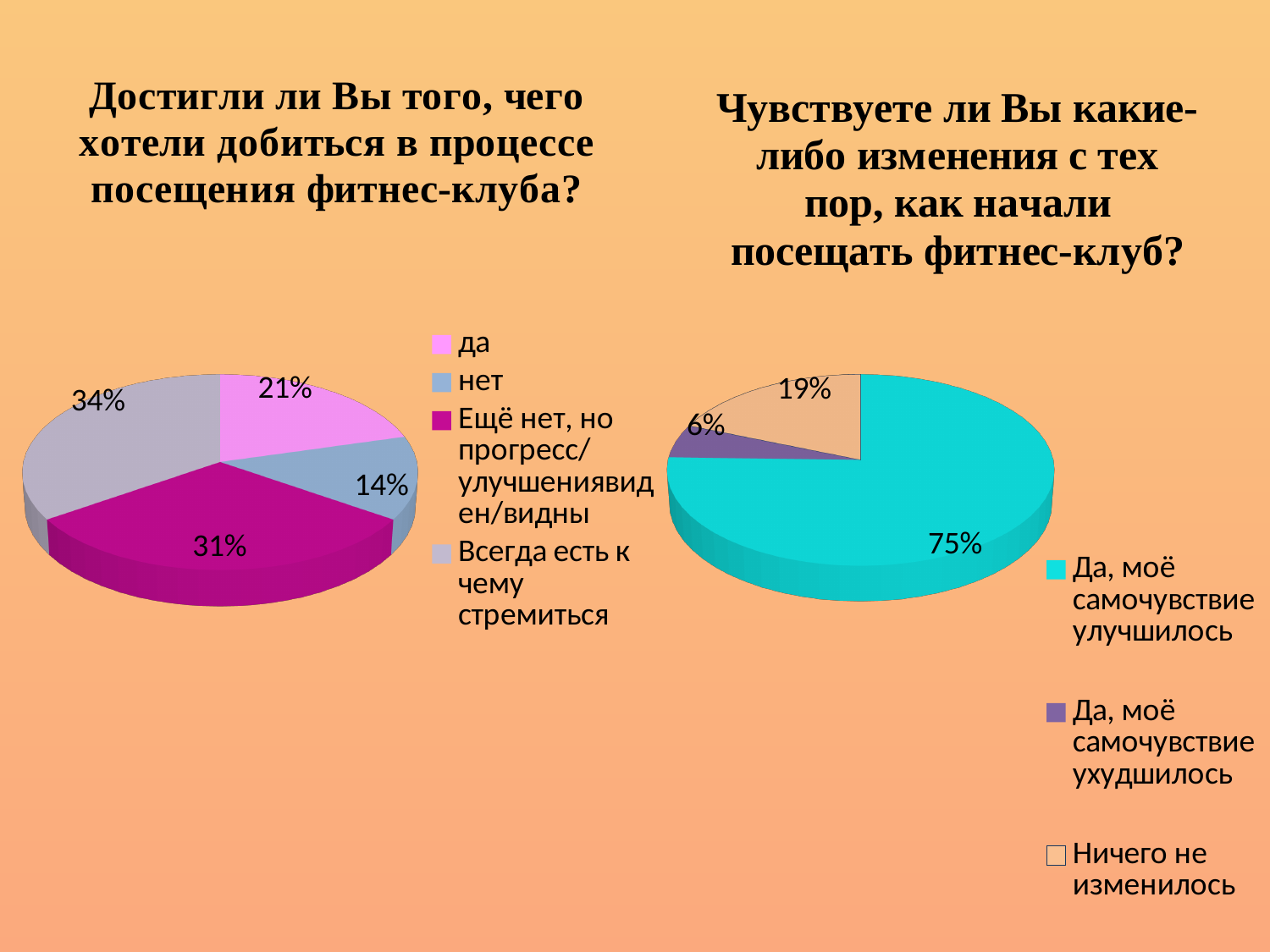
In the left chart ("Достигли ли Вы того, чего хотели добиться..."), what percentage is shown for "Всегда есть к чему стремиться"? 34% In the left chart ("Достигли ли Вы того, чего хотели добиться..."), which answer has the smallest share? нет In the left chart ("Достигли ли Вы того, чего хотели добиться..."), what percentage answered "нет"? 14% In the right chart ("Чувствуете ли Вы какие-либо изменения..."), which is larger: "Ничего не изменилось" or "Да, моё самочувствие ухудшилось"? Ничего не изменилось In the left chart ("Достигли ли Вы того, чего хотели добиться..."), which answer has the largest share? Всегда есть к чему стремиться In the right chart ("Чувствуете ли Вы какие-либо изменения..."), what percentage answered "Да, моё самочувствие ухудшилось"? 6% In the left chart ("Достигли ли Вы того, чего хотели добиться в процессе посещения фитнес-клуба?"), what percentage answered "да"? 21% In the right chart ("Чувствуете ли Вы какие-либо изменения..."), what percentage answered "Да, моё самочувствие улучшилось"? 75% What type of chart is used on the right side of the slide ("Чувствуете ли Вы какие-либо изменения...")? Pie chart In the right chart ("Чувствуете ли Вы какие-либо изменения..."), what percentage answered "Ничего не изменилось"? 19% In the left chart ("Достигли ли Вы того, чего хотели добиться..."), what is the difference in percentage points between "Всегда есть к чему стремиться" and "да"? 13 In the left chart ("Достигли ли Вы того, чего хотели добиться..."), how many slices does the pie have? 4